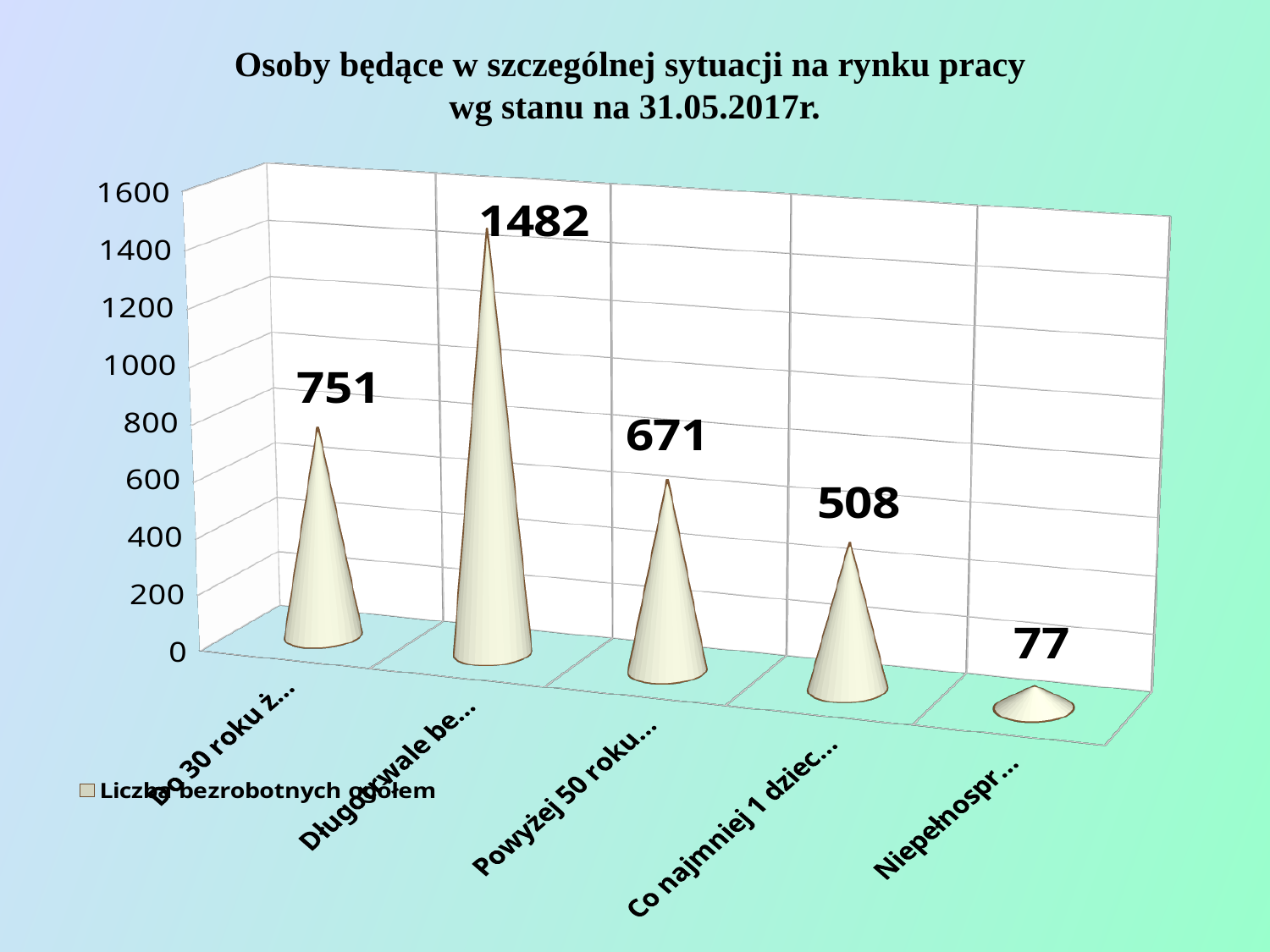
Which category has the highest value? Długotrwale be... What is the difference between the values for the categories beginning "Długotrwale" and "Do 30 roku"? 731 What is the value for the category whose label begins "Powyżej 50 roku"? 671 Is the value for the category beginning "Co najmniej 1 dziec" greater or less than 600? less What is the value for the category whose label begins "Do 30 roku"? 751 What is the value for the category whose label begins "Długotrwale"? 1482 What is the series name shown in the legend? Liczba bezrobotnych ogółem What is the value for the category whose label begins "Niepełnospr"? 77 Which category has the lowest value? Niepełnospr... Which is larger: the value for the category beginning "Powyżej 50 roku" or the one beginning "Co najmniej 1 dziec"? Powyżej 50 roku... How many categories are shown on the chart? 5 How many series does the legend list? 1